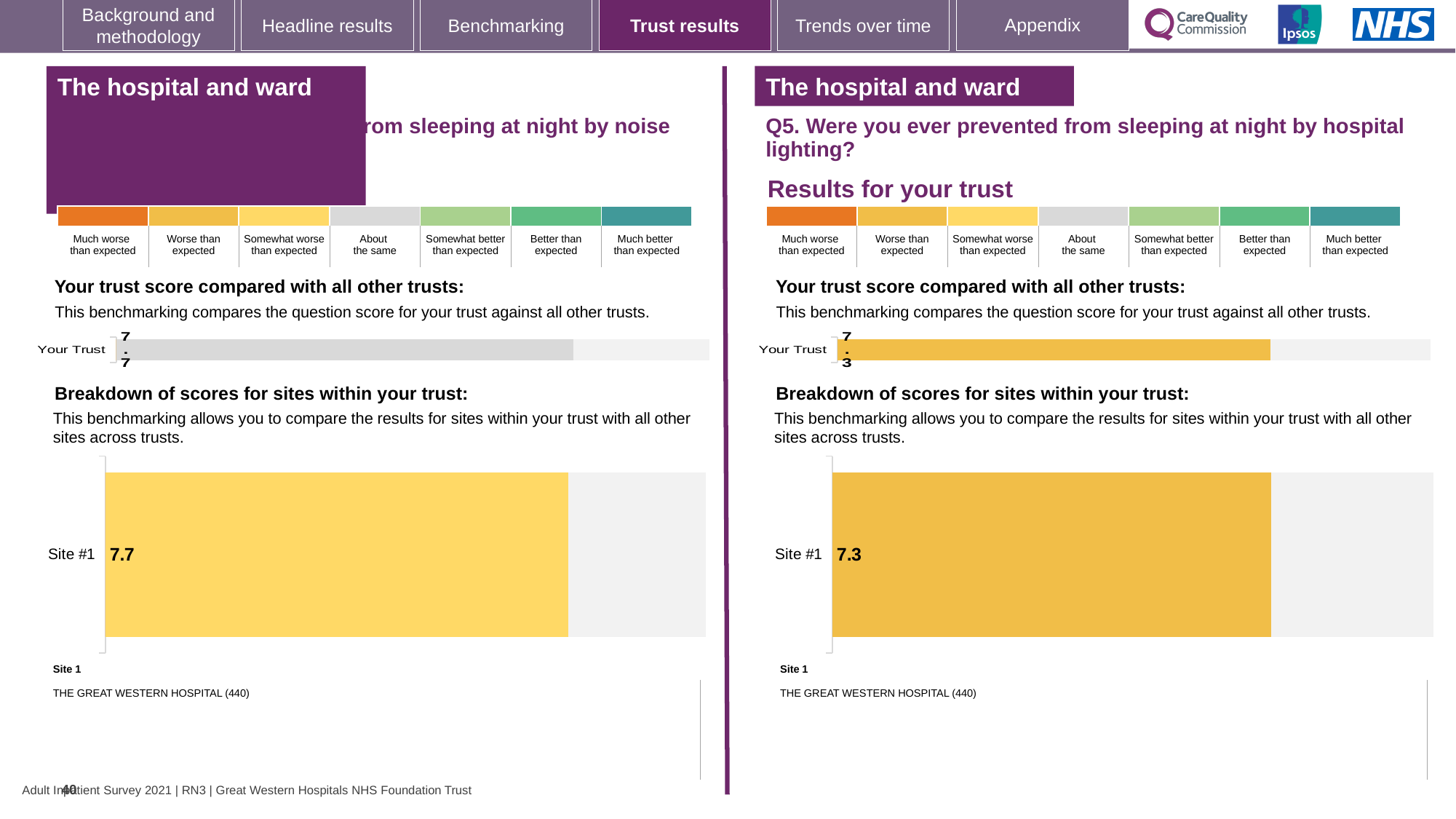
Which site is listed as Site 1 below the charts on the right half of the slide (Q5)? THE GREAT WESTERN HOSPITAL (440) On the right half of the slide (Q5, hospital lighting), what is the score shown for Your Trust? 7.3 What is the difference between the Your Trust score on the left half of the slide and the Your Trust score on the right half (Q5)? 0.4 How many sites are shown in the 'Breakdown of scores for sites within your trust' chart on the right half of the slide (Q5)? 1 Which is larger: the Site #1 score on the left half of the slide or the Site #1 score on the right half (Q5)? Left half (7.7) On the left half of the slide, which benchmark category does the colour of the Your Trust bar correspond to? About the same On the right half of the slide (Q5, hospital lighting), what score is shown for Site #1? 7.3 What type of chart is used to show the Site #1 score on the right half of the slide (Q5)? Bar chart On the left half of the slide, what score is shown for Site #1 in the 'Breakdown of scores for sites within your trust' chart? 7.7 On the left half of the slide, what is the score shown for Your Trust in the 'Your trust score compared with all other trusts' chart? 7.7 On the right half of the slide (Q5), which benchmark category does the colour of the Your Trust bar correspond to? Worse than expected